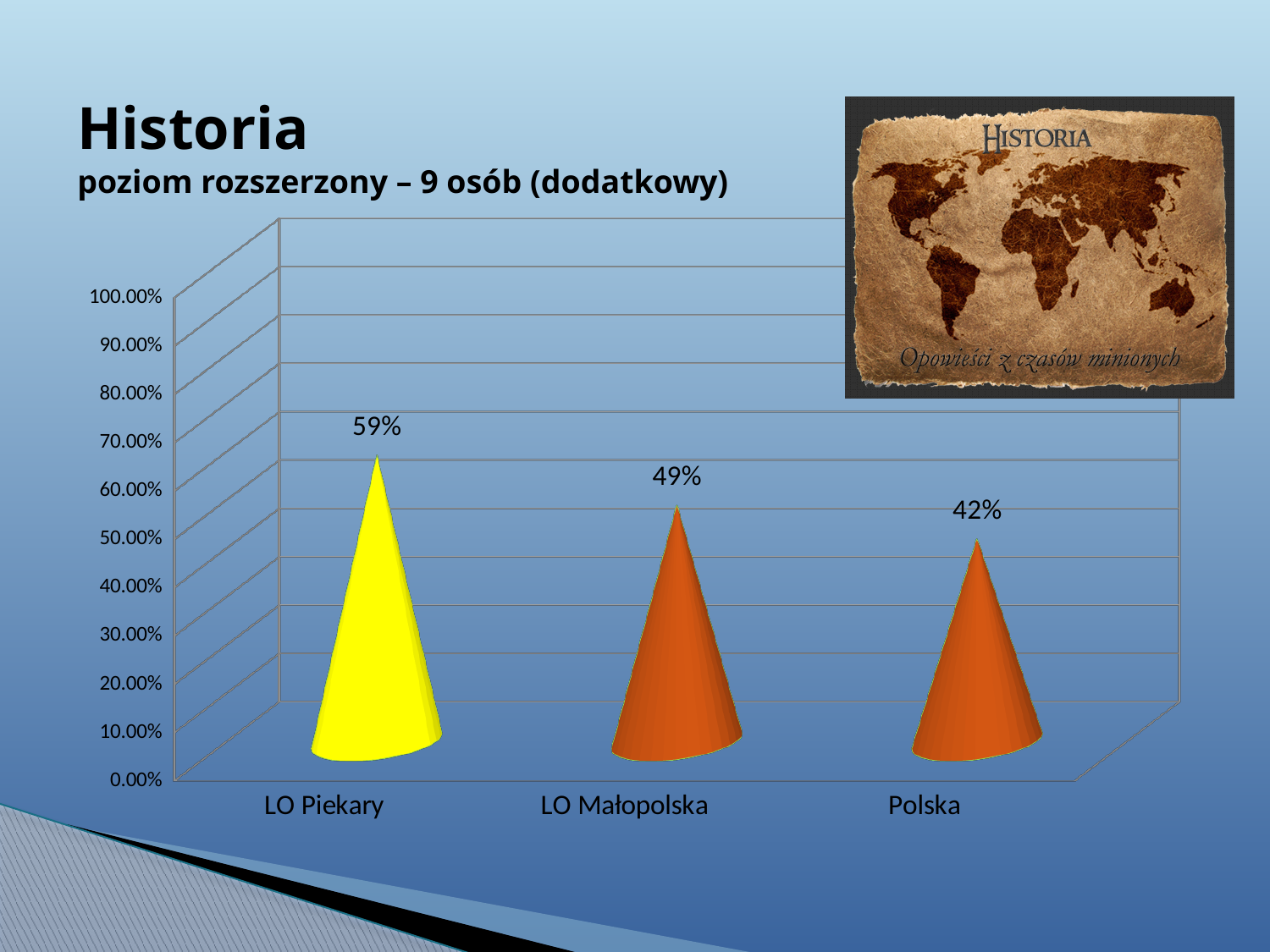
Which is larger, the value for LO Piekary or the value for LO Małopolska? LO Piekary What is the value for Polska? 42% Is the value for Polska greater or less than 50.00%? less What kind of chart is shown on the slide? bar chart What is the value for LO Piekary? 59% Which category has the highest value? LO Piekary What is the value for LO Małopolska? 49% Which category has the lowest value? Polska What is the difference between the values for LO Piekary and Polska? 17% What is the difference between the values for LO Małopolska and Polska? 7% How many categories are shown on the x axis? 3 Do the values rise or fall from left to right along the x axis? fall